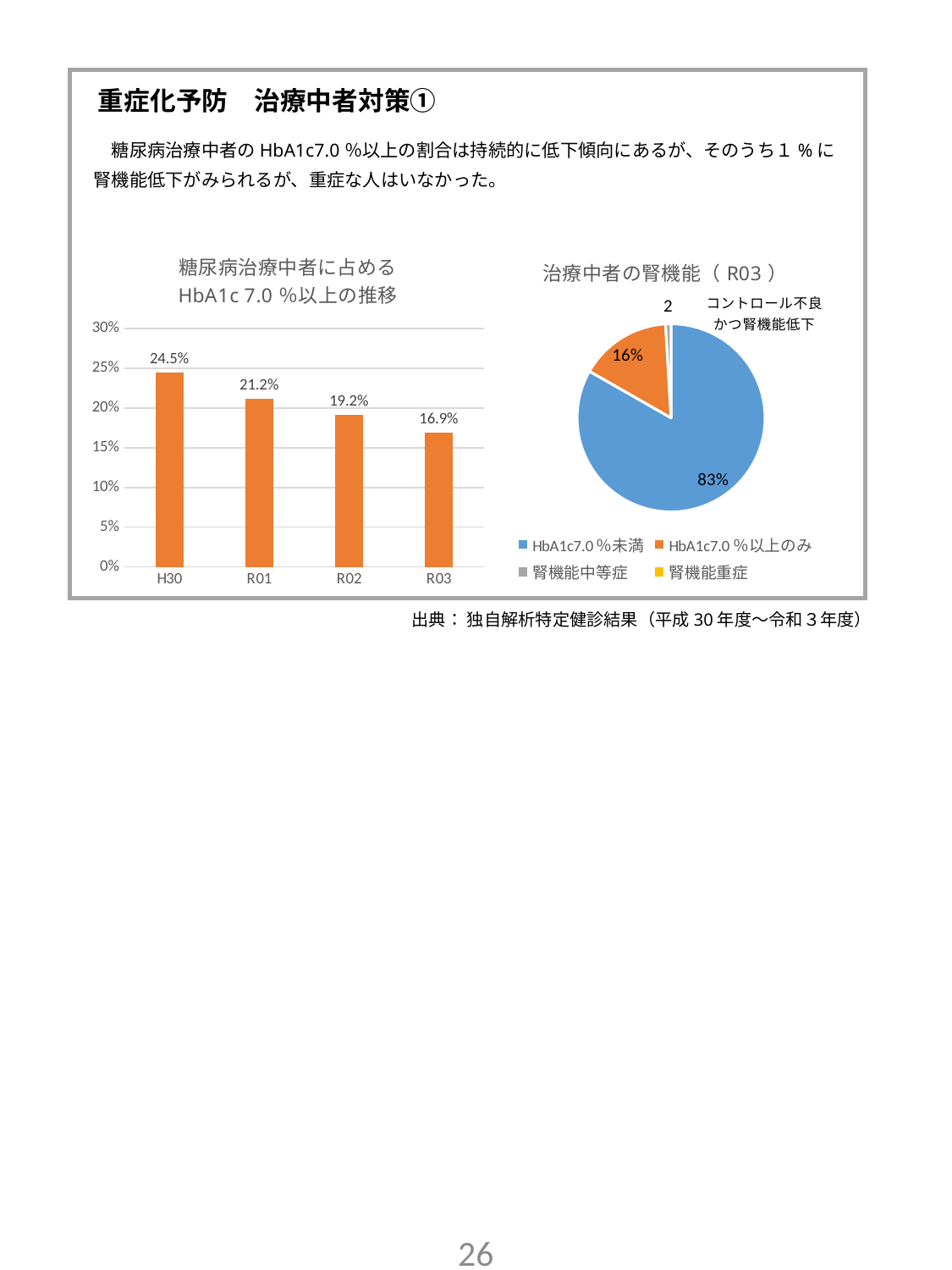
In the bar chart titled 糖尿病治療中者に占めるHbA1c 7.0％以上の推移, what is the value for R03? 16.9% How many entries does the legend of the pie chart titled 治療中者の腎機能（R03）list? 4 In the bar chart titled 糖尿病治療中者に占めるHbA1c 7.0％以上の推移, what is the value for R01? 21.2% In the pie chart titled 治療中者の腎機能（R03）, what share is labelled for the HbA1c7.0％以上のみ slice? 16% In the bar chart titled 糖尿病治療中者に占めるHbA1c 7.0％以上の推移, how many years are shown on the x axis? 4 In the bar chart titled 糖尿病治療中者に占めるHbA1c 7.0％以上の推移, which year has the lowest value? R03 In the bar chart titled 糖尿病治療中者に占めるHbA1c 7.0％以上の推移, which year has the highest value? H30 In the bar chart titled 糖尿病治療中者に占めるHbA1c 7.0％以上の推移, what is the difference between the values for H30 and R03? 7.6% What kind of chart is the chart on the left of the slide? bar chart In the bar chart titled 糖尿病治療中者に占めるHbA1c 7.0％以上の推移, what is the value for H30? 24.5% In the bar chart titled 糖尿病治療中者に占めるHbA1c 7.0％以上の推移, do the values rise or fall from H30 to R03? fall In the pie chart titled 治療中者の腎機能（R03）, what share is labelled for the HbA1c7.0％未満 slice? 83%